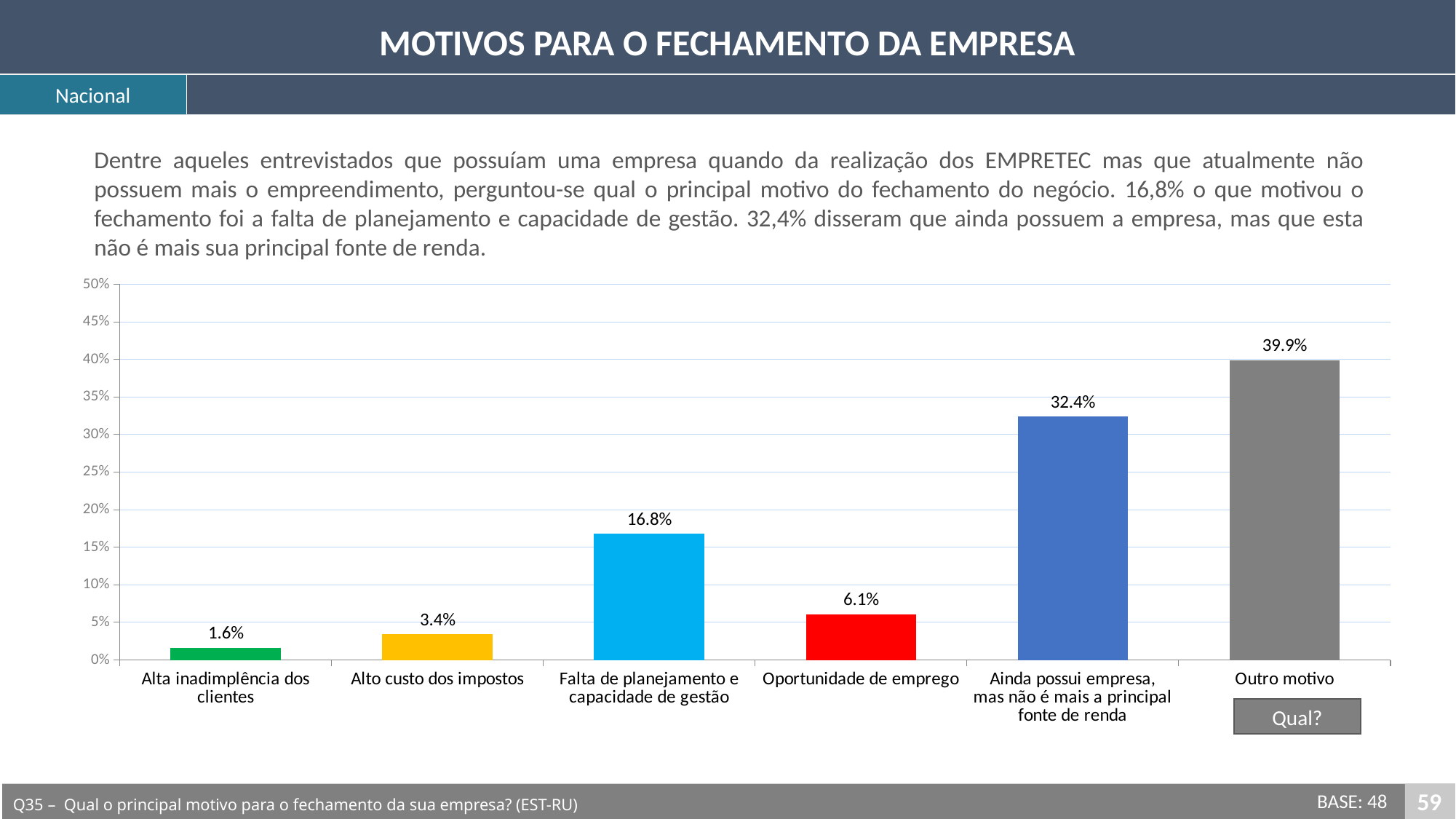
Which is larger: 'Falta de planejamento e capacidade de gestão' or 'Oportunidade de emprego'? Falta de planejamento e capacidade de gestão Which category has the highest value? Outro motivo Is the value for 'Ainda possui empresa, mas não é mais a principal fonte de renda' greater or less than 30%? greater What kind of chart is shown on the slide? bar chart What is the value for 'Falta de planejamento e capacidade de gestão'? 16.8% What is the difference between 'Oportunidade de emprego' and 'Alto custo dos impostos'? 2.7% Which category has the lowest value? Alta inadimplência dos clientes What is the difference between 'Outro motivo' and 'Ainda possui empresa, mas não é mais a principal fonte de renda'? 7.5% How many categories are shown in the chart? 6 What is the value for 'Alto custo dos impostos'? 3.4% What is the value for 'Oportunidade de emprego'? 6.1% What is the title of the slide containing the chart? MOTIVOS PARA O FECHAMENTO DA EMPRESA